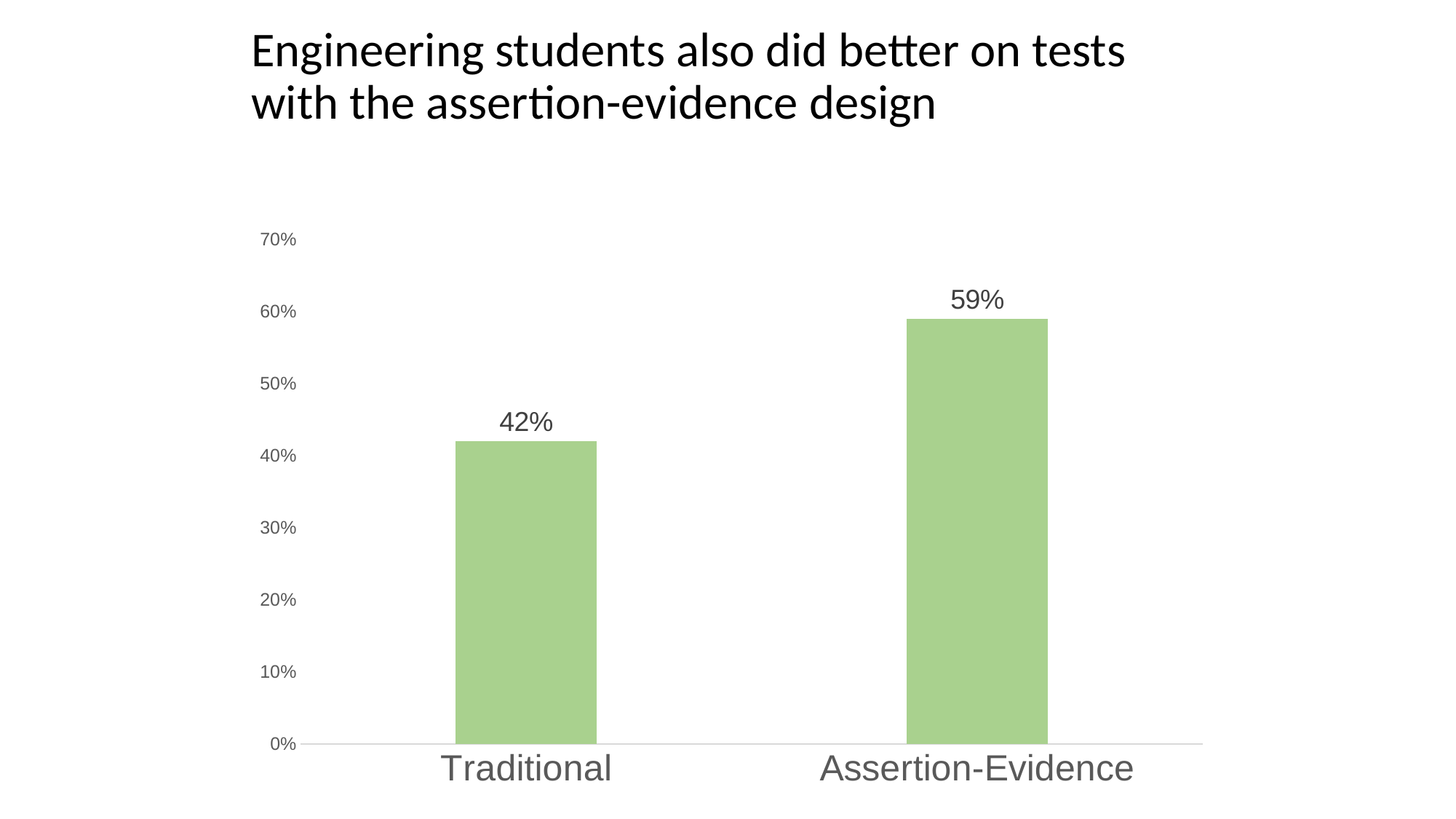
What is the value for Traditional? 42% Which category has the lowest value? Traditional What kind of chart is shown on the slide? bar chart Is the value for Assertion-Evidence greater or less than 50%? greater How many categories are shown on the x axis? 2 Which is larger, the value for Traditional or the value for Assertion-Evidence? Assertion-Evidence What is the difference between the values for Assertion-Evidence and Traditional? 17% Which category has the highest value? Assertion-Evidence Is the value for Traditional greater or less than 50%? less What is the value for Assertion-Evidence? 59% What is the highest value shown on the y axis? 70% Do the values rise or fall from Traditional to Assertion-Evidence? rise